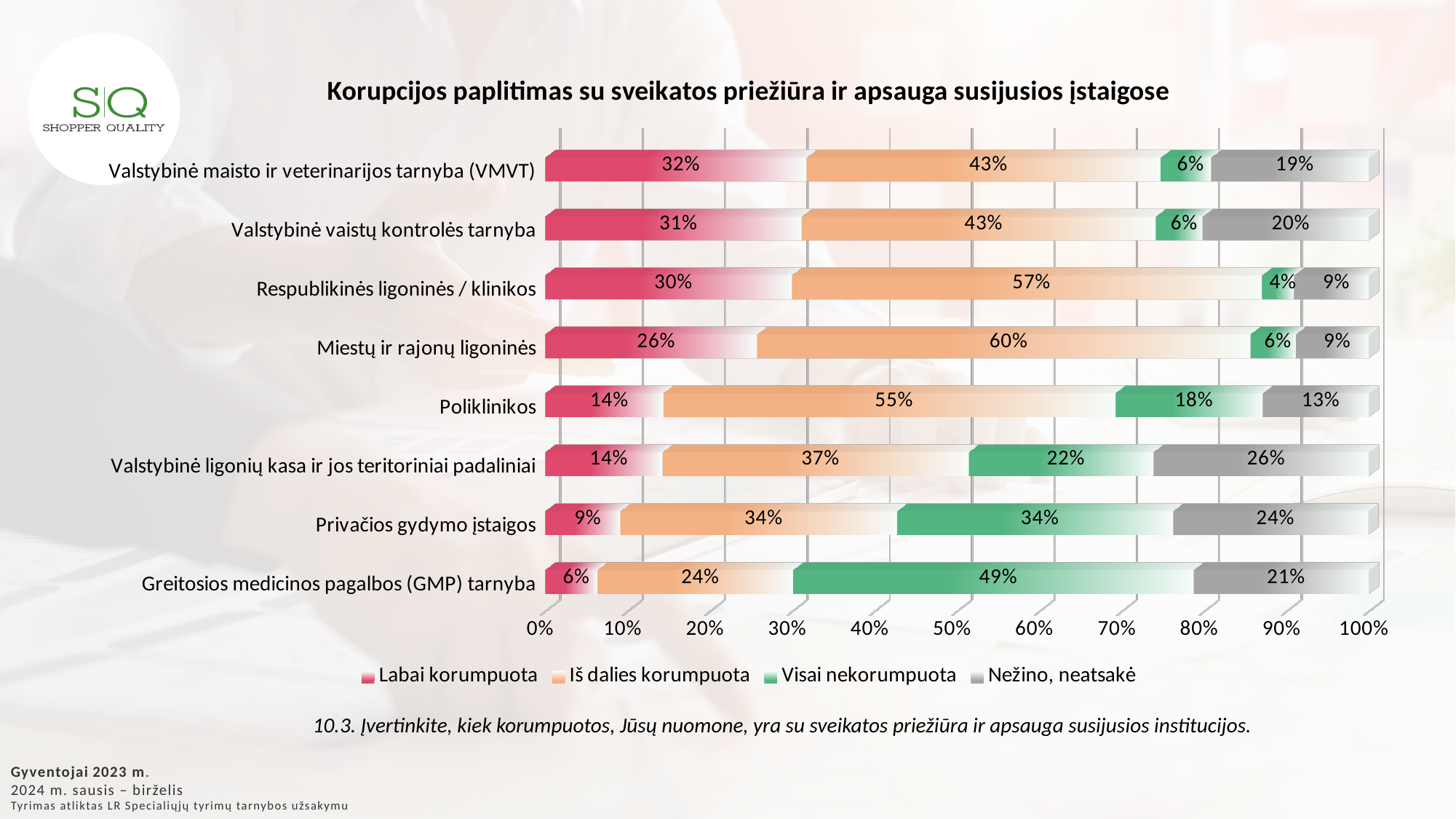
Which category has the highest 'Labai korumpuota' value? Valstybinė maisto ir veterinarijos tarnyba (VMVT) What is the total of the stacked bar for Poliklinikos? 100% What is the 'Labai korumpuota' value for Valstybinė maisto ir veterinarijos tarnyba (VMVT)? 32% What is the 'Iš dalies korumpuota' value for Miestų ir rajonų ligoninės? 60% What is the 'Visai nekorumpuota' value for Greitosios medicinos pagalbos (GMP) tarnyba? 49% How many categories (institutions) are shown on the chart? 8 What is the difference between the 'Iš dalies korumpuota' values for Respublikinės ligoninės / klinikos and Poliklinikos? 2% How many series does the legend list? 4 What kind of chart is shown on the slide? Stacked bar chart Which category has the lowest 'Visai nekorumpuota' value? Respublikinės ligoninės / klinikos Which is larger: the 'Visai nekorumpuota' value for Privačios gydymo įstaigos or for Poliklinikos? Privačios gydymo įstaigos What is the 'Nežino, neatsakė' value for Valstybinė ligonių kasa ir jos teritoriniai padaliniai? 26%